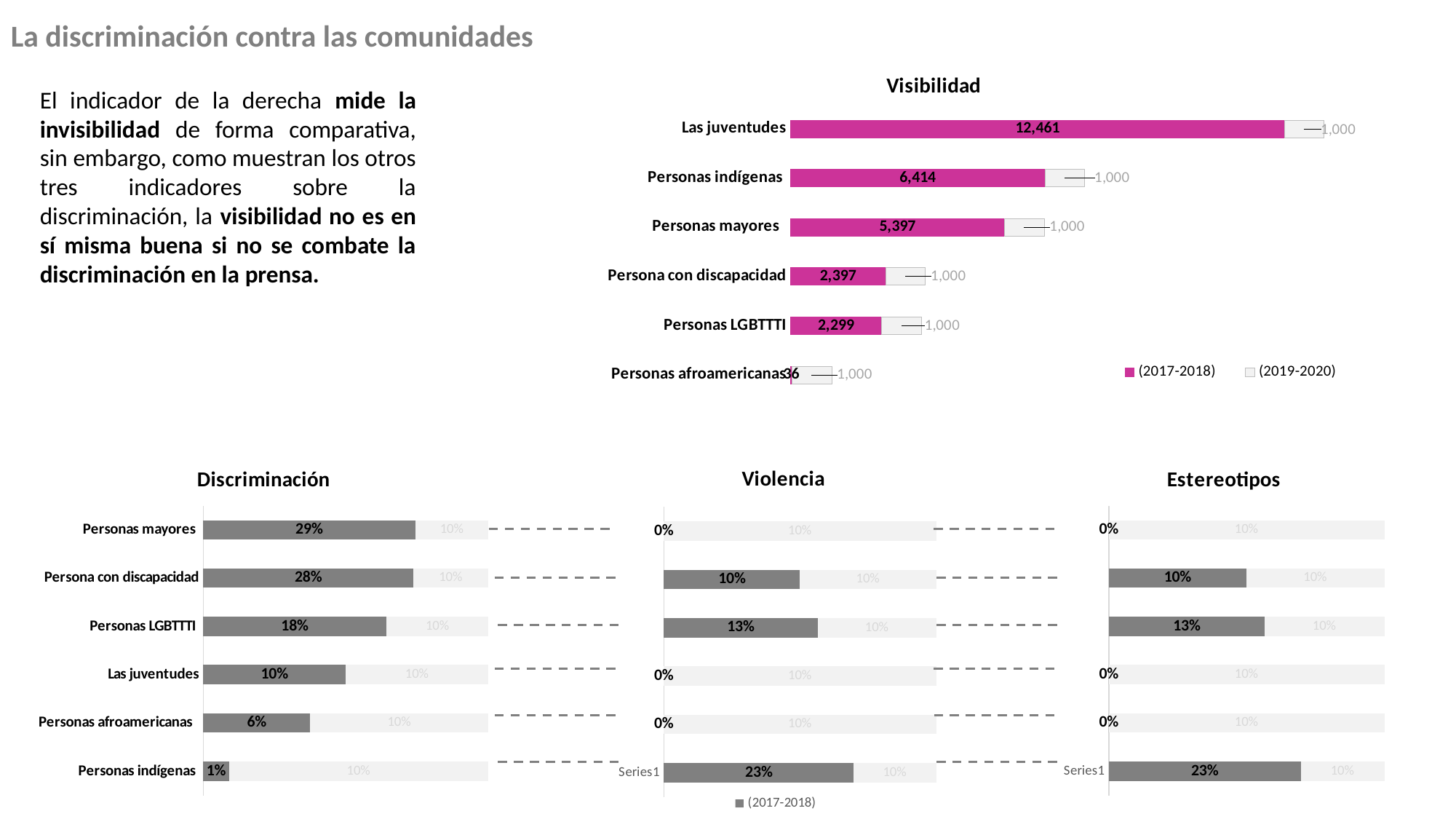
In the Discriminación chart, which category has the lowest (2017-2018) value? Personas indígenas In the Visibilidad chart, what is the (2017-2018) value for Personas mayores? 5,397 What is the title of the chart at the top of the slide? Visibilidad What kind of chart is the Visibilidad chart? Bar chart In the Discriminación chart, what is the (2017-2018) value for Personas LGBTTTI? 18% In the Discriminación chart, how many categories are shown? 6 In the Estereotipos chart, which is larger: the (2017-2018) value for the second bar from the top (Persona con discapacidad) or the third bar (Personas LGBTTTI)? Personas LGBTTTI In the Visibilidad chart, what is the difference between the (2017-2018) values for Personas indígenas and Personas mayores? 1,017 In the Visibilidad chart, what is the (2017-2018) value for Las juventudes? 12,461 In the Violencia chart, what is the (2017-2018) value for the bottom category (Personas indígenas)? 23% In the Visibilidad chart, which category has the highest (2017-2018) value? Las juventudes In the Visibilidad chart, how many series does the legend list? 2